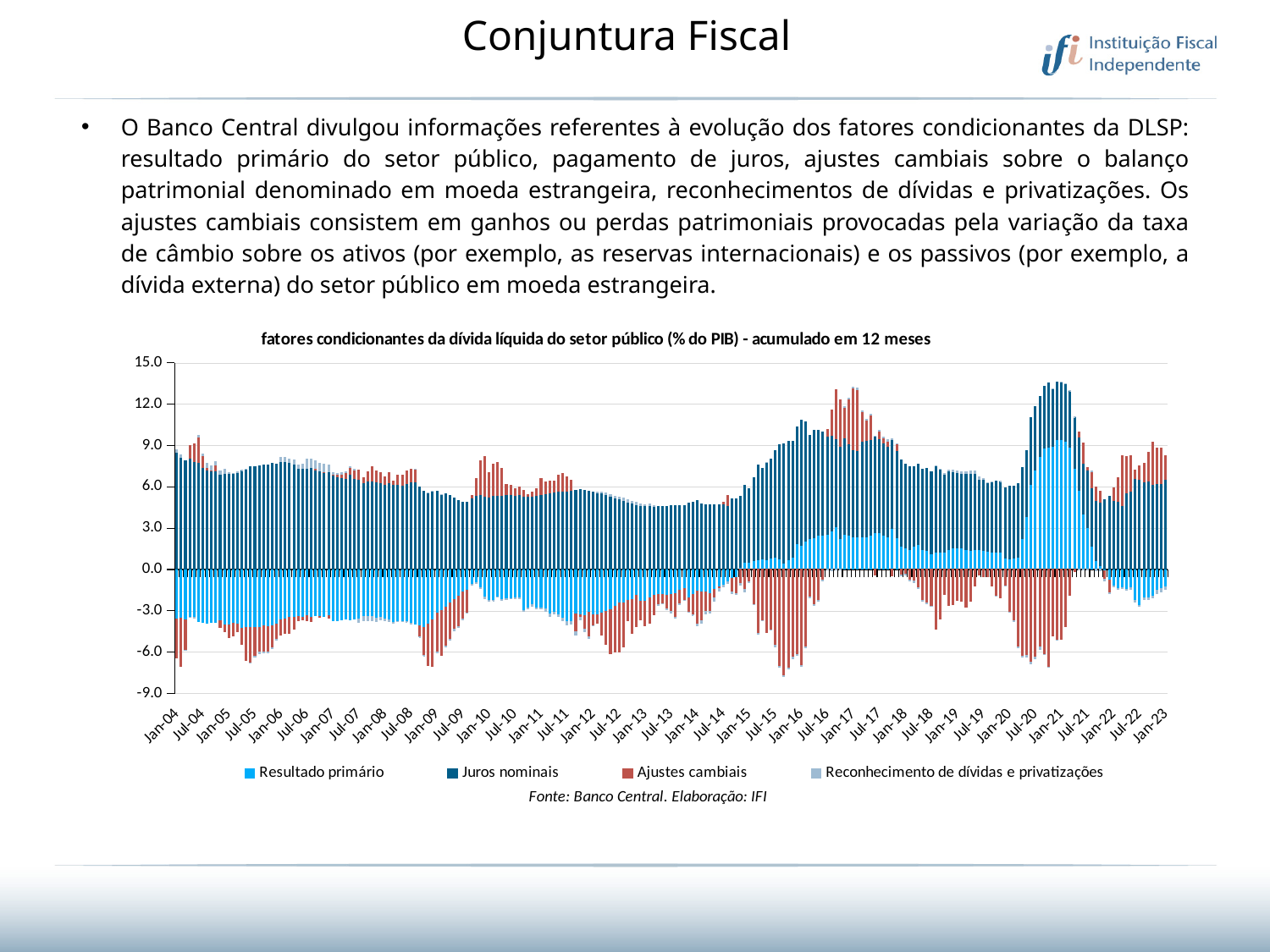
Is the total of the positive stacked bar for Jan-21 greater or less than 12.0? greater Is the value of Resultado primário for Jan-21 greater or less than 6.0? greater Is the value of Juros nominais for Jan-04 greater or less than 6.0? greater What is the highest value shown on the y axis of the chart? 15.0 What kind of chart is shown on the slide? Stacked bar chart Which series in the chart is shown in red? Ajustes cambiais What is the title of the chart? fatores condicionantes da dívida líquida do setor público (% do PIB) - acumulado em 12 meses What is the last month label on the x axis of the chart? Jan-23 What is the first month label on the x axis of the chart? Jan-04 How many series does the legend of the chart list? 4 What is the lowest value shown on the y axis of the chart? -9.0